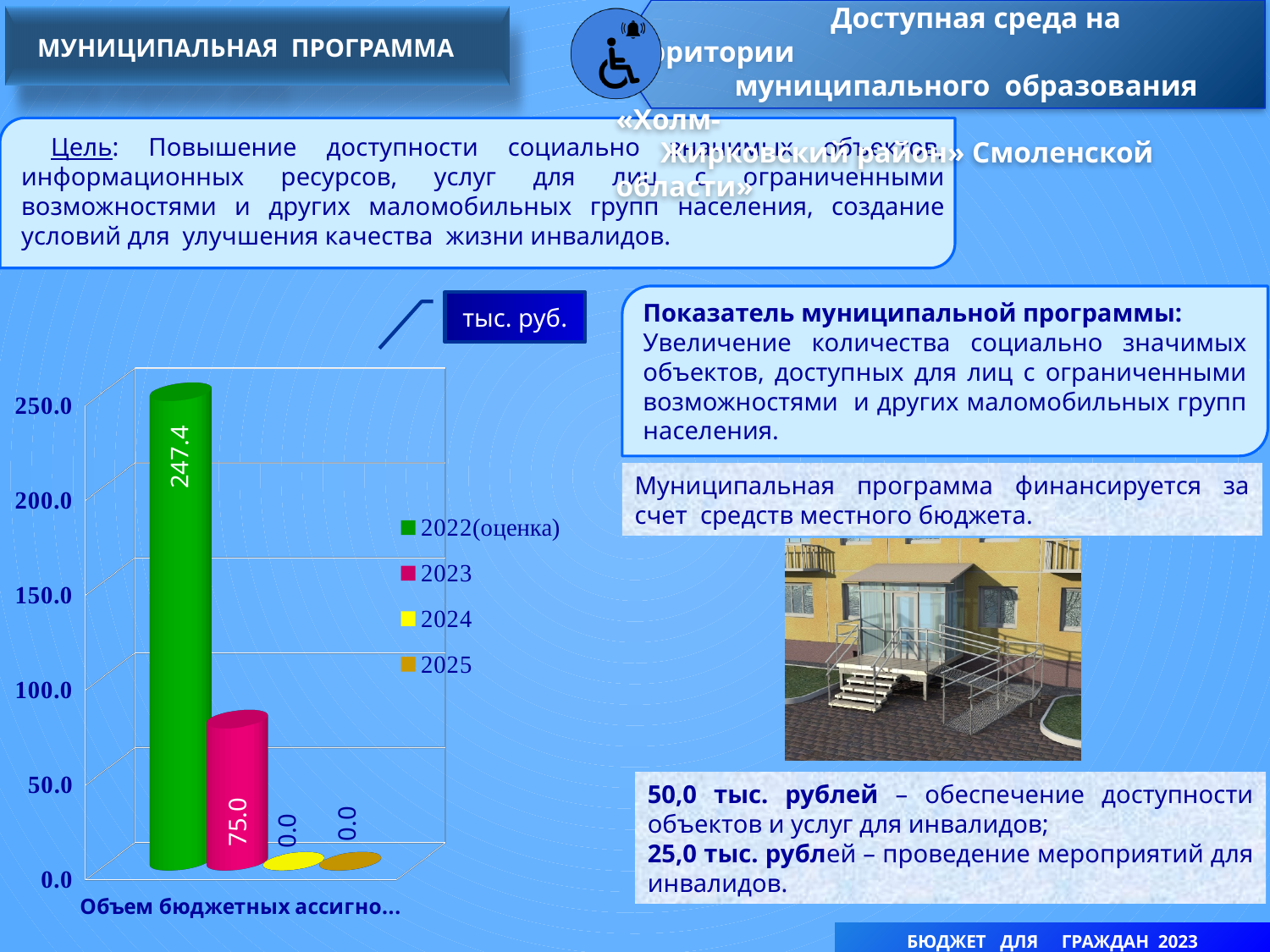
Which is larger, the value for 2022(оценка) or the value for 2023? 2022(оценка) What kind of chart is shown on the slide? bar chart How many series does the chart legend list? 4 What is the value for 2023 on the chart? 75.0 What unit is indicated for the chart values? тыс. руб. What is the value for 2024 on the chart? 0.0 What is the value for 2022(оценка) on the chart? 247.4 What is the value for 2025 on the chart? 0.0 Which series has the highest value on the chart? 2022(оценка) Is the value for 2022(оценка) greater or less than 200.0? greater Is the value for 2023 greater or less than 100.0? less What is the difference between the values for 2022(оценка) and 2023? 172.4